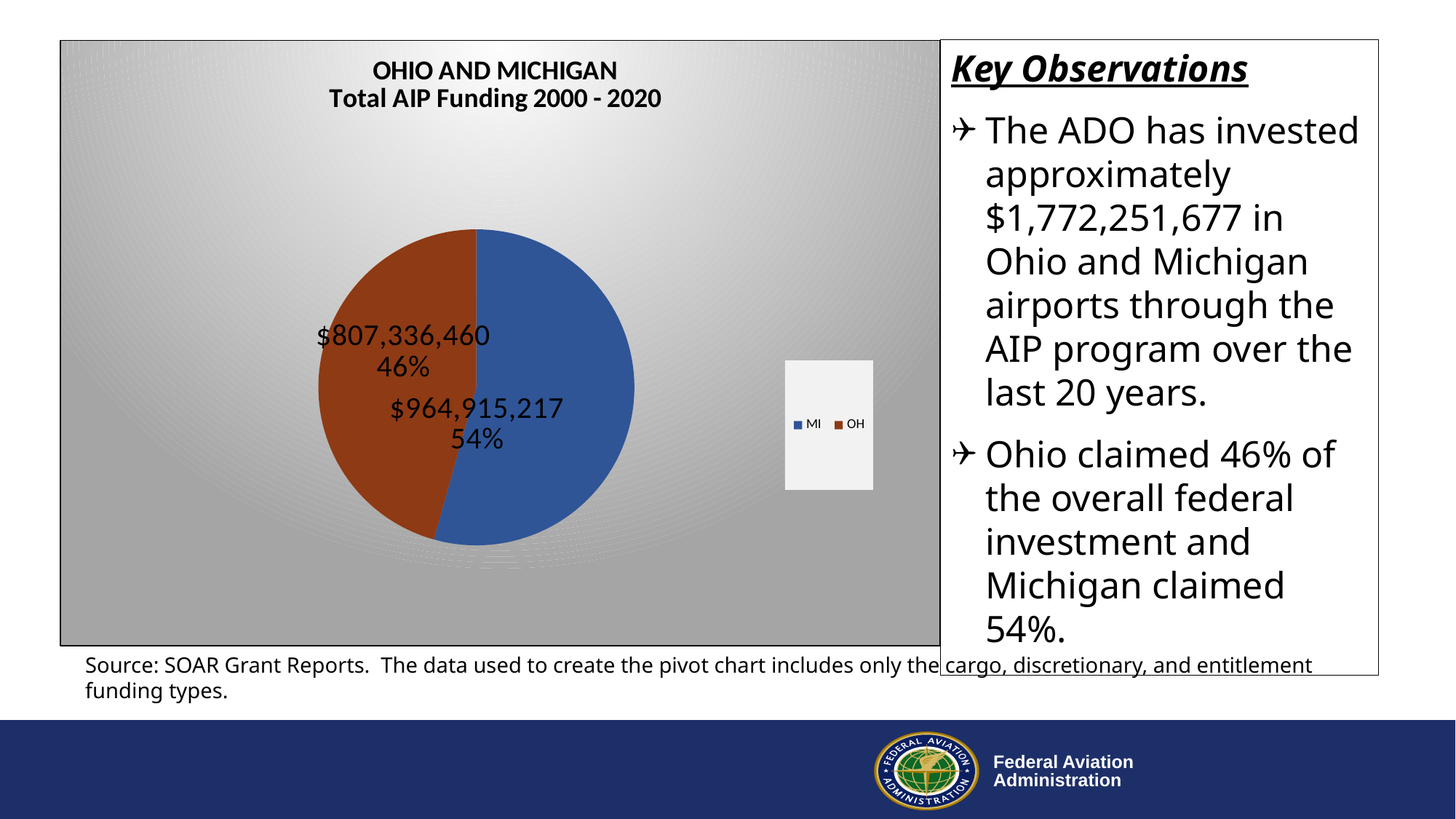
What share of the pie does the OH slice represent? 46% What is the combined total of the two slices in the pie chart? $1,772,251,677 What is the total AIP funding value shown for MI? $964,915,217 Which state has the larger slice of the pie? MI Is the funding value for MI larger or smaller than the value for OH? Larger What is the total AIP funding value shown for OH? $807,336,460 How many slices does the pie chart have? 2 What share of the pie does the MI slice represent? 54% What type of chart is shown on the slide? Pie chart What is the title of the pie chart? OHIO AND MICHIGAN Total AIP Funding 2000 - 2020 Which state has the smaller slice of the pie? OH What is the difference between the MI and OH funding values? $157,578,757